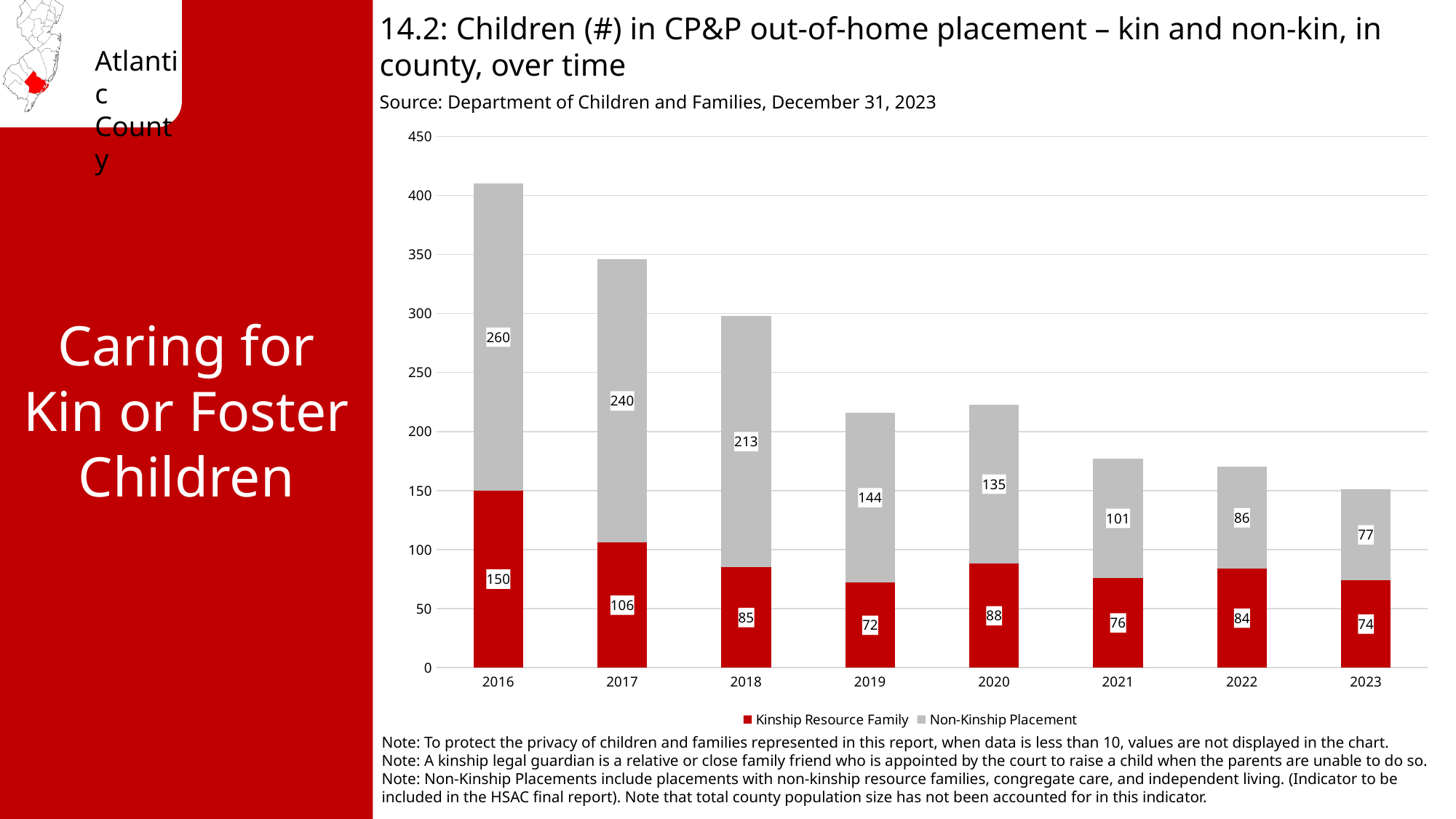
What is the total of the stacked bar for 2016? 410 What is the difference between the Non-Kinship Placement values for 2017 and 2018? 27 What is the Kinship Resource Family value for 2016? 150 Which is larger, the Kinship Resource Family value for 2020 or for 2022? 2020 What is the Non-Kinship Placement value for 2019? 144 Which year has the highest Non-Kinship Placement value? 2016 Which year has the lowest Kinship Resource Family value? 2019 How many series does the legend list? 2 How many years are shown on the x axis? 8 What kind of chart is shown? Stacked bar chart What is the Non-Kinship Placement value for 2023? 77 What is the total of the stacked bar for 2021? 177